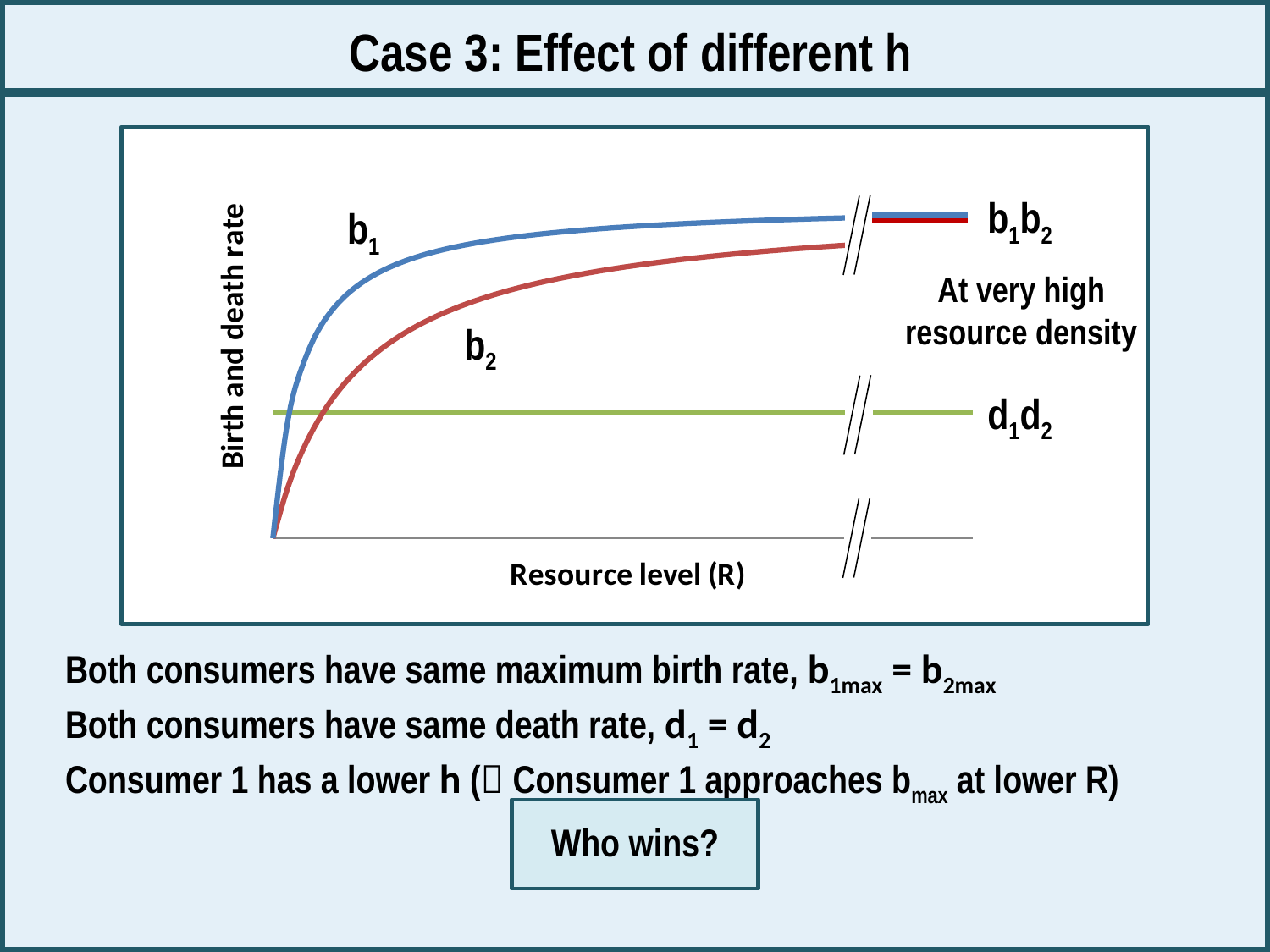
Which curve crosses the d1d2 line at a lower resource level, b1 or b2? b1 Does the b2 curve rise or fall as resource level (R) increases? Rise Which curve reaches its plateau at a lower resource level, b1 or b2? b1 Which plotted line is the lowest on the chart at high resource levels? d1d2 What kind of chart is shown on the slide? Line chart Does the d1d2 line rise, fall, or stay flat as resource level (R) increases? Stay flat At intermediate resource levels, which curve is higher, b1 or b2? b1 What is the label of the y axis of the chart? Birth and death rate Does the b1 curve rise or fall as resource level (R) increases? Rise What is the label of the x axis of the chart? Resource level (R) How many curves or lines are plotted on the chart? 3